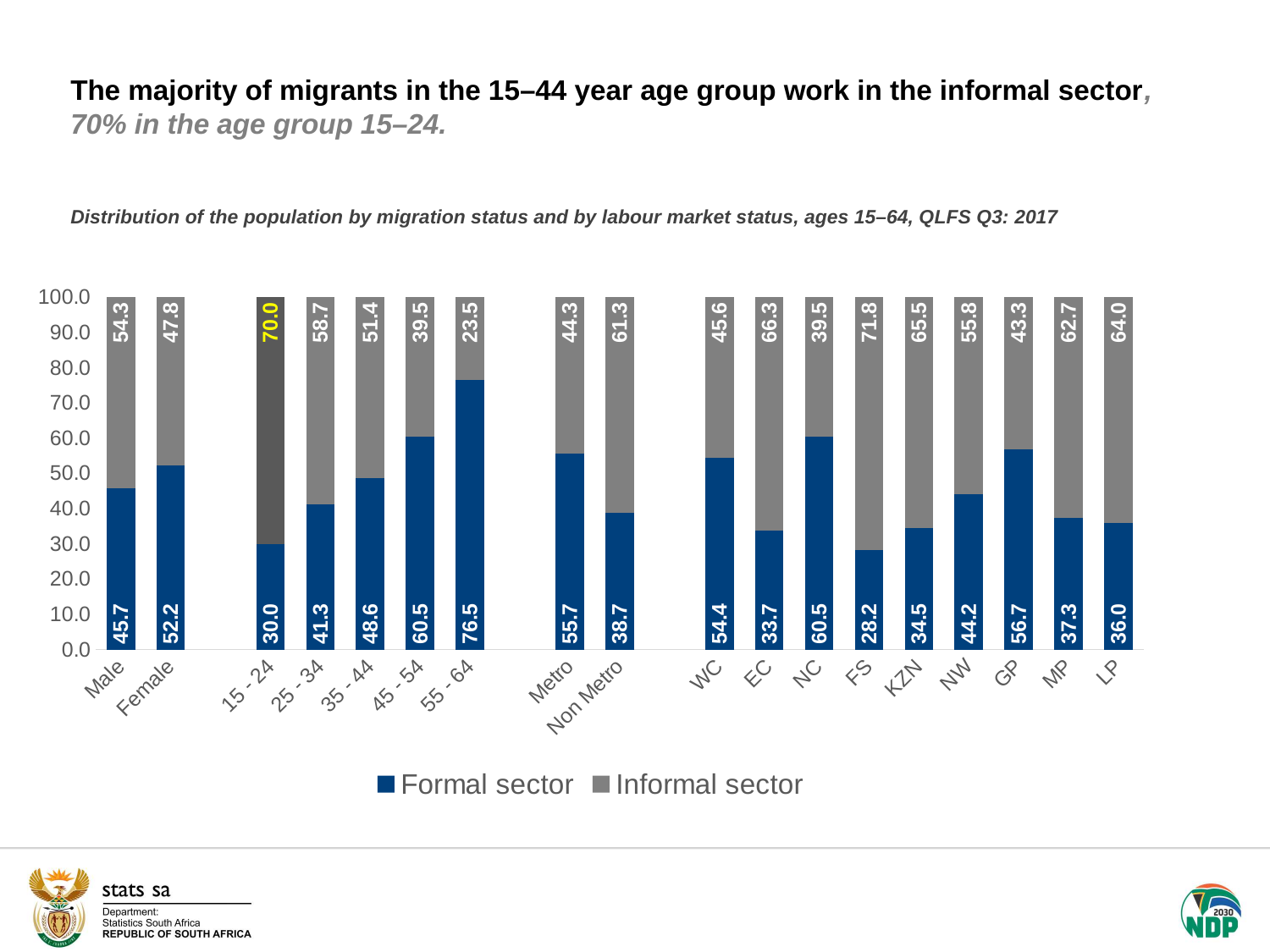
How many categories are shown on the x axis? 18 What kind of chart is shown on the slide? Stacked bar chart What is the total of the stacked bar for EC? 100.0 What is the Formal sector value for Non Metro? 38.7 Which category has the highest Formal sector value? 55 - 64 What is the Formal sector value for Male? 45.7 How many series does the legend list? 2 Which has the larger Formal sector value, Metro or Non Metro? Metro Which category has the lowest Formal sector value? FS What is the Informal sector value for the 15 - 24 age group? 70.0 Which category has the highest Informal sector value? FS What is the difference between the Formal sector values for Female and Male? 6.5